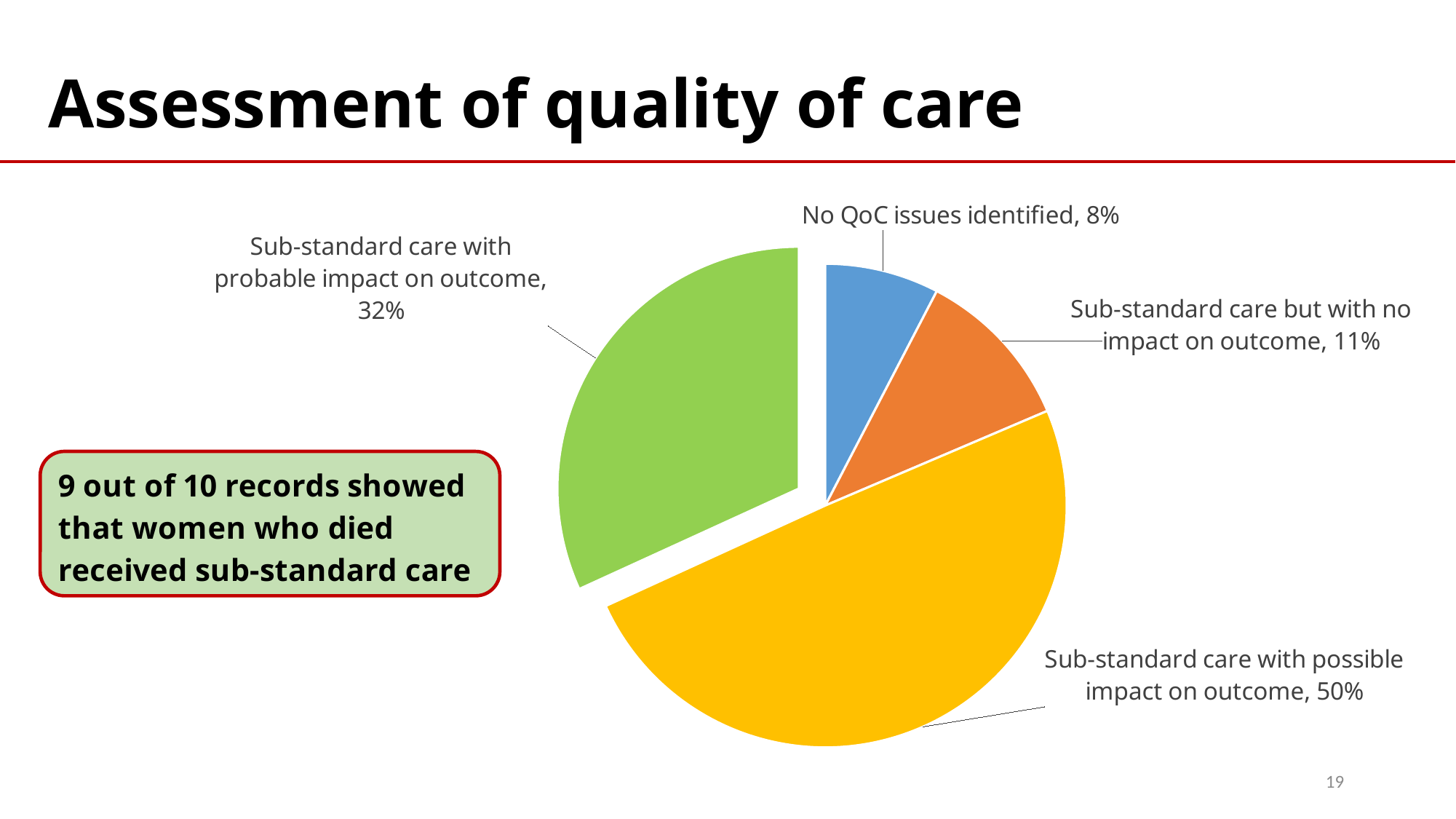
What colour is the slice for 'Sub-standard care with probable impact on outcome'? Green What share of the pie is 'Sub-standard care but with no impact on outcome'? 11% Which is larger: 'Sub-standard care but with no impact on outcome' or 'No QoC issues identified'? Sub-standard care but with no impact on outcome Which category has the largest slice of the pie? Sub-standard care with possible impact on outcome What kind of chart is shown on the slide? Pie chart What share of the pie is 'Sub-standard care with possible impact on outcome'? 50% How many slices does the pie chart have? 4 Which category has the smallest slice of the pie? No QoC issues identified What is the difference in percentage points between 'Sub-standard care with possible impact on outcome' and 'Sub-standard care with probable impact on outcome'? 18 percentage points What share of the pie is 'No QoC issues identified'? 8% What is the title of the slide containing the pie chart? Assessment of quality of care